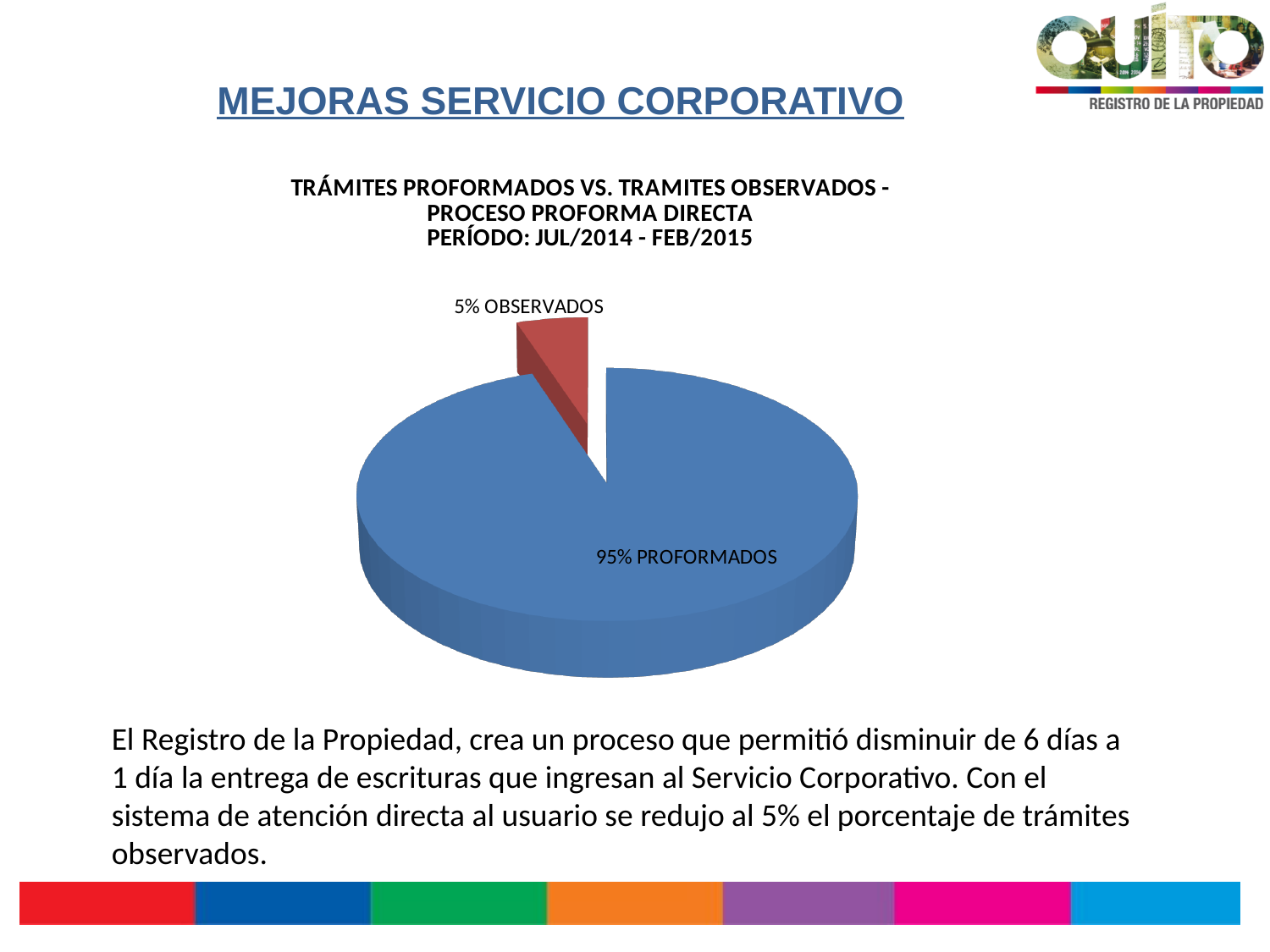
Which slice of the pie is the largest? PROFORMADOS Which is larger, the PROFORMADOS slice or the OBSERVADOS slice? PROFORMADOS What colour is the OBSERVADOS slice? Red What period does the chart title say the data covers? JUL/2014 - FEB/2015 What percentage of the pie is labelled OBSERVADOS? 5% How many slices does the pie chart have? 2 Which slice of the pie is the smallest? OBSERVADOS What kind of chart is shown on the slide? Pie chart What share of the pie does the OBSERVADOS slice represent? 5% What percentage of the pie is labelled PROFORMADOS? 95% What is the difference in percentage points between the PROFORMADOS and OBSERVADOS slices? 90